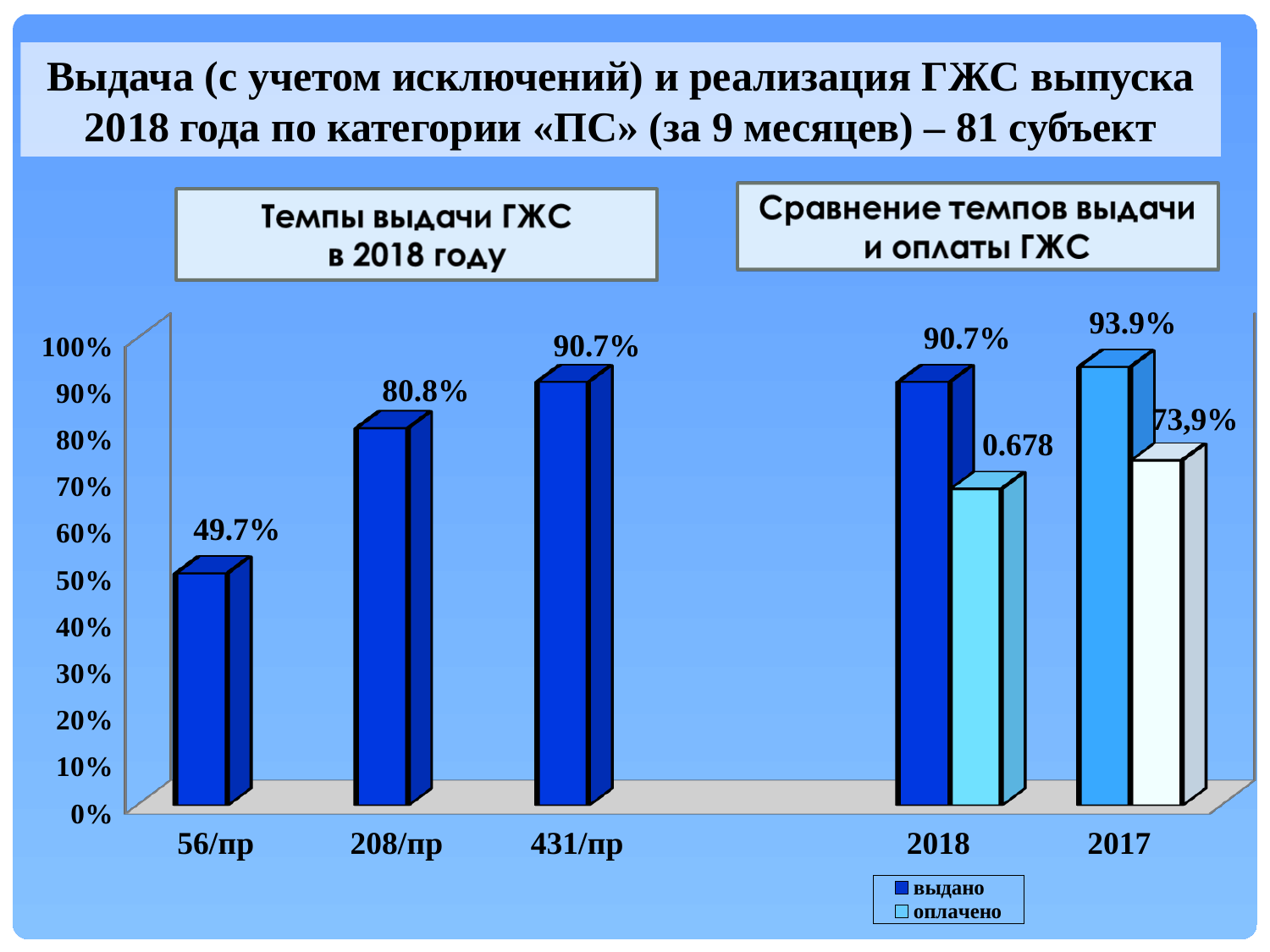
What type of chart is 'Сравнение темпов выдачи и оплаты ГЖС'? bar chart In the chart 'Темпы выдачи ГЖС в 2018 году', what is the value for 56/пр? 49.7% In the chart 'Темпы выдачи ГЖС в 2018 году', how many categories are shown? 3 In the chart 'Темпы выдачи ГЖС в 2018 году', what is the difference between the values for 431/пр and 56/пр? 41.0% In the chart 'Сравнение темпов выдачи и оплаты ГЖС', what is the value of 'выдано' for 2017? 93.9% In the chart 'Темпы выдачи ГЖС в 2018 году', what is the value for 208/пр? 80.8% In the chart 'Темпы выдачи ГЖС в 2018 году', which category has the highest value? 431/пр In the chart 'Темпы выдачи ГЖС в 2018 году', which category has the lowest value? 56/пр In the chart 'Сравнение темпов выдачи и оплаты ГЖС', what is the value of 'оплачено' for 2018? 0.678 In the chart 'Сравнение темпов выдачи и оплаты ГЖС', how many series does the legend list? 2 In the chart 'Сравнение темпов выдачи и оплаты ГЖС', which is larger for 2017: 'выдано' or 'оплачено'? выдано In the chart 'Темпы выдачи ГЖС в 2018 году', do the values rise or fall from left to right? rise